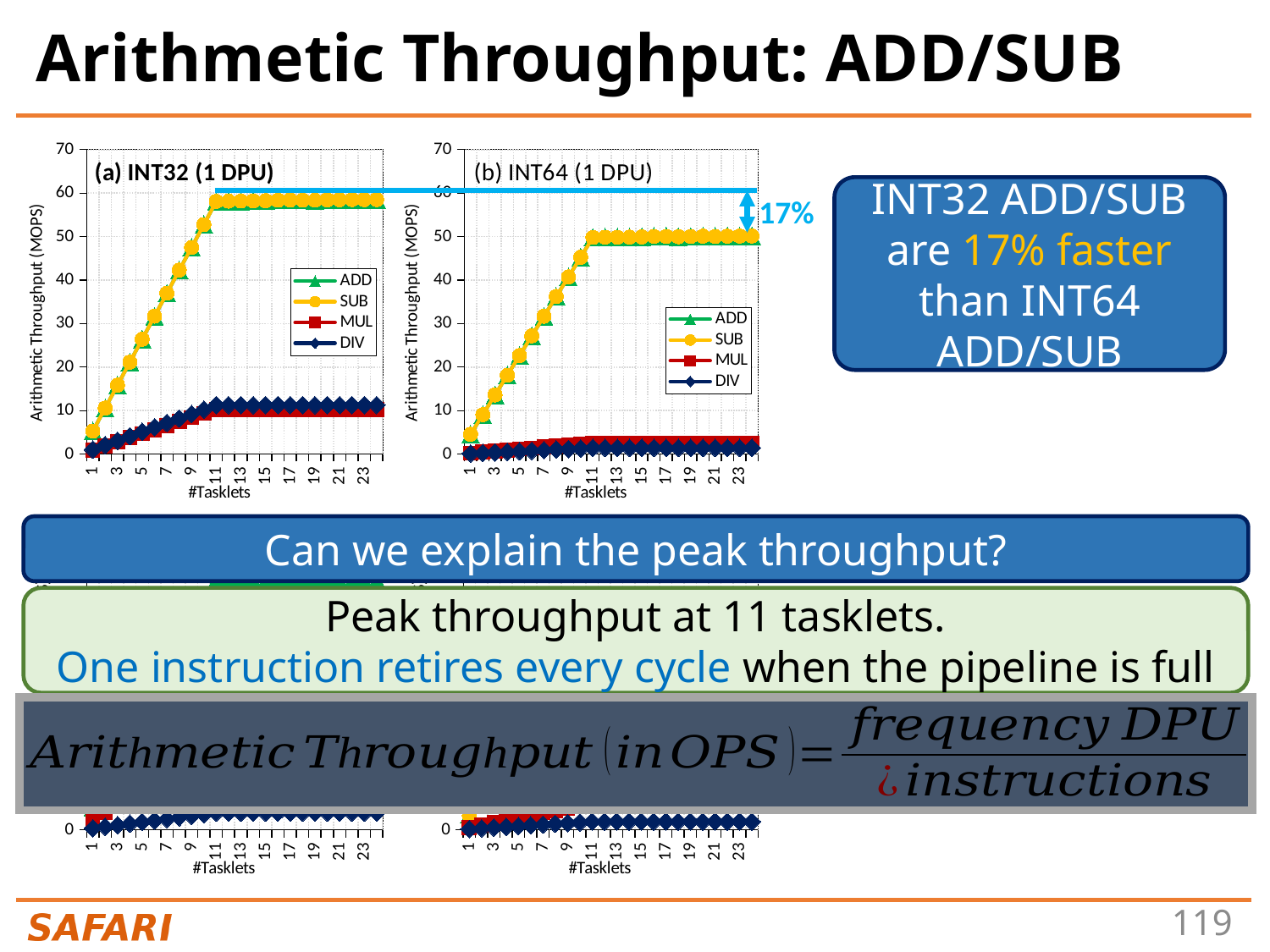
What kind of chart is the (a) INT32 (1 DPU) chart? line chart What is the y-axis label of the (a) INT32 (1 DPU) chart? Arithmetic Throughput (MOPS) In the (a) INT32 (1 DPU) chart, is the SUB value at 1 tasklet greater or less than 10? less Which chart reaches a higher plateau for ADD: (a) INT32 (1 DPU) or (b) INT64 (1 DPU)? (a) INT32 (1 DPU) In the (a) INT32 (1 DPU) chart, is the ADD value at 23 tasklets greater or less than 50? greater How many series does the legend of the (b) INT64 (1 DPU) chart list? 4 In the (b) INT64 (1 DPU) chart, does the SUB series rise or fall as the number of tasklets increases from 1 to 11? rise In the (b) INT64 (1 DPU) chart, is the MUL value at 23 tasklets greater or less than 10? less What is the x-axis label of the (b) INT64 (1 DPU) chart? #Tasklets In the (a) INT32 (1 DPU) chart, which is larger at 23 tasklets: ADD or DIV? ADD